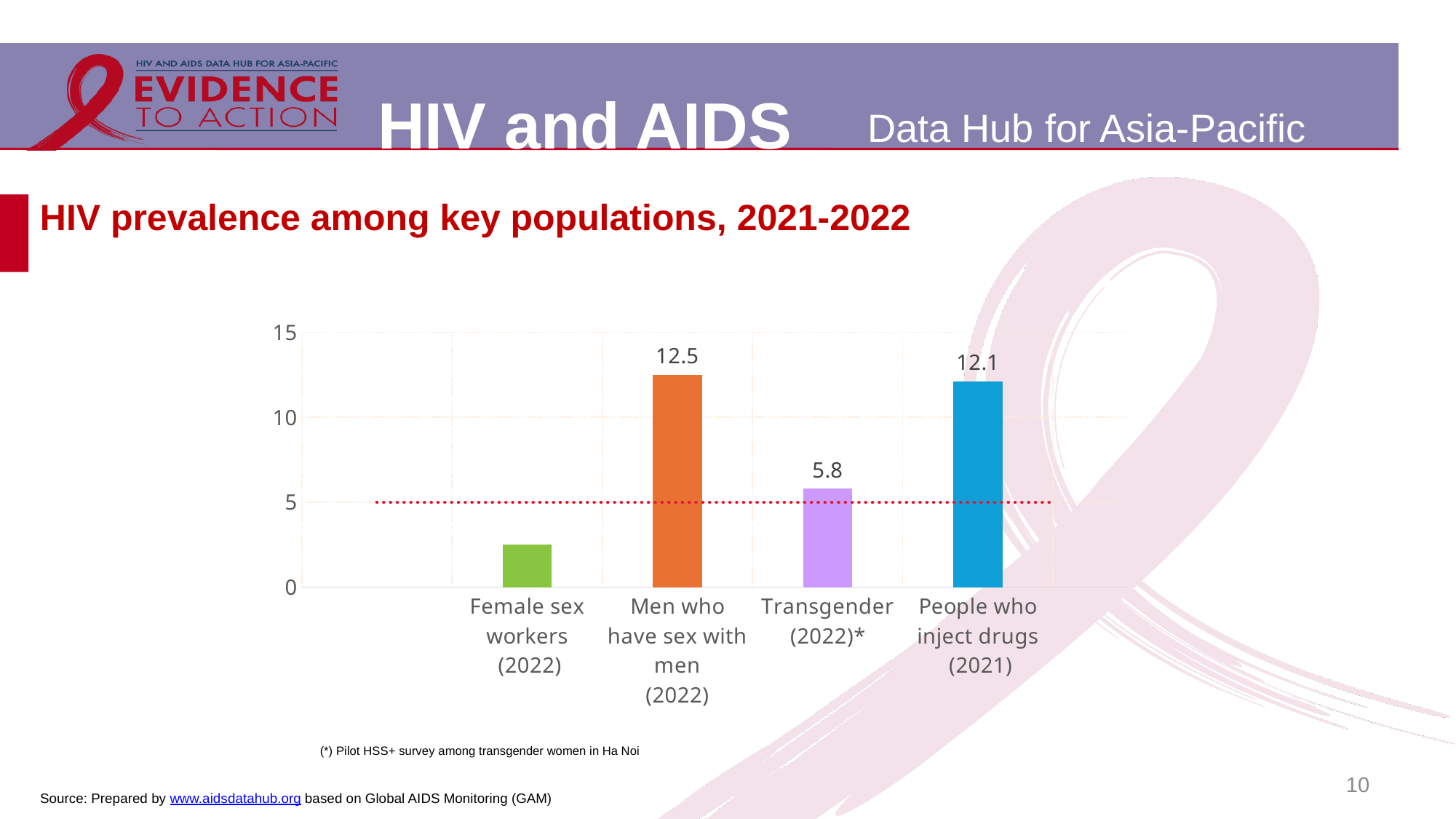
Which key population has the lowest HIV prevalence in the chart? Female sex workers (2022) What kind of chart is shown on the slide? Bar chart What is the HIV prevalence value shown for men who have sex with men (2022)? 12.5 What is the difference between the HIV prevalence for men who have sex with men (2022) and transgender (2022)*? 6.7 What is the HIV prevalence value shown for people who inject drugs (2021)? 12.1 Is the value for female sex workers (2022) greater or less than 5? less Which key population has the highest HIV prevalence in the chart? Men who have sex with men (2022) What is the HIV prevalence value shown for transgender (2022)*? 5.8 Which is larger: the HIV prevalence for people who inject drugs (2021) or for transgender (2022)*? People who inject drugs (2021) How many key populations are shown in the chart? 4 At what value on the y axis is the red dotted horizontal line drawn? 5 What is the difference between the HIV prevalence for men who have sex with men (2022) and people who inject drugs (2021)? 0.4